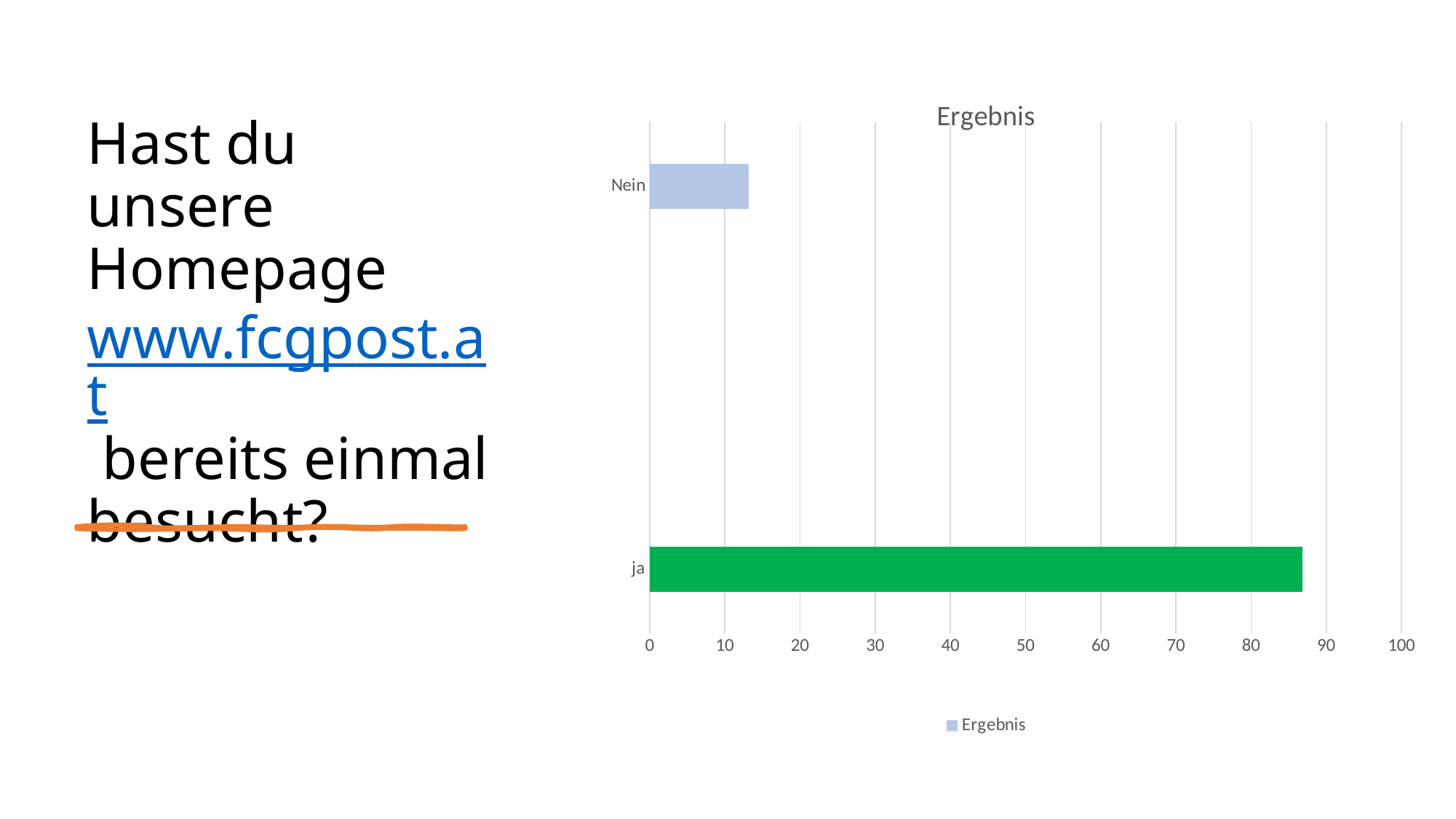
How many categories are plotted in the chart? 2 What is the title of the chart? Ergebnis What is the name of the series shown in the legend? Ergebnis Is the value for Nein greater or less than 10? greater Which category has the highest value? ja Is the value for Nein greater or less than 20? less Is the value for ja greater or less than 90? less Which category has the lowest value? Nein Which is larger, the value for ja or the value for Nein? ja What kind of chart is shown on the slide? bar chart How many series does the legend list? 1